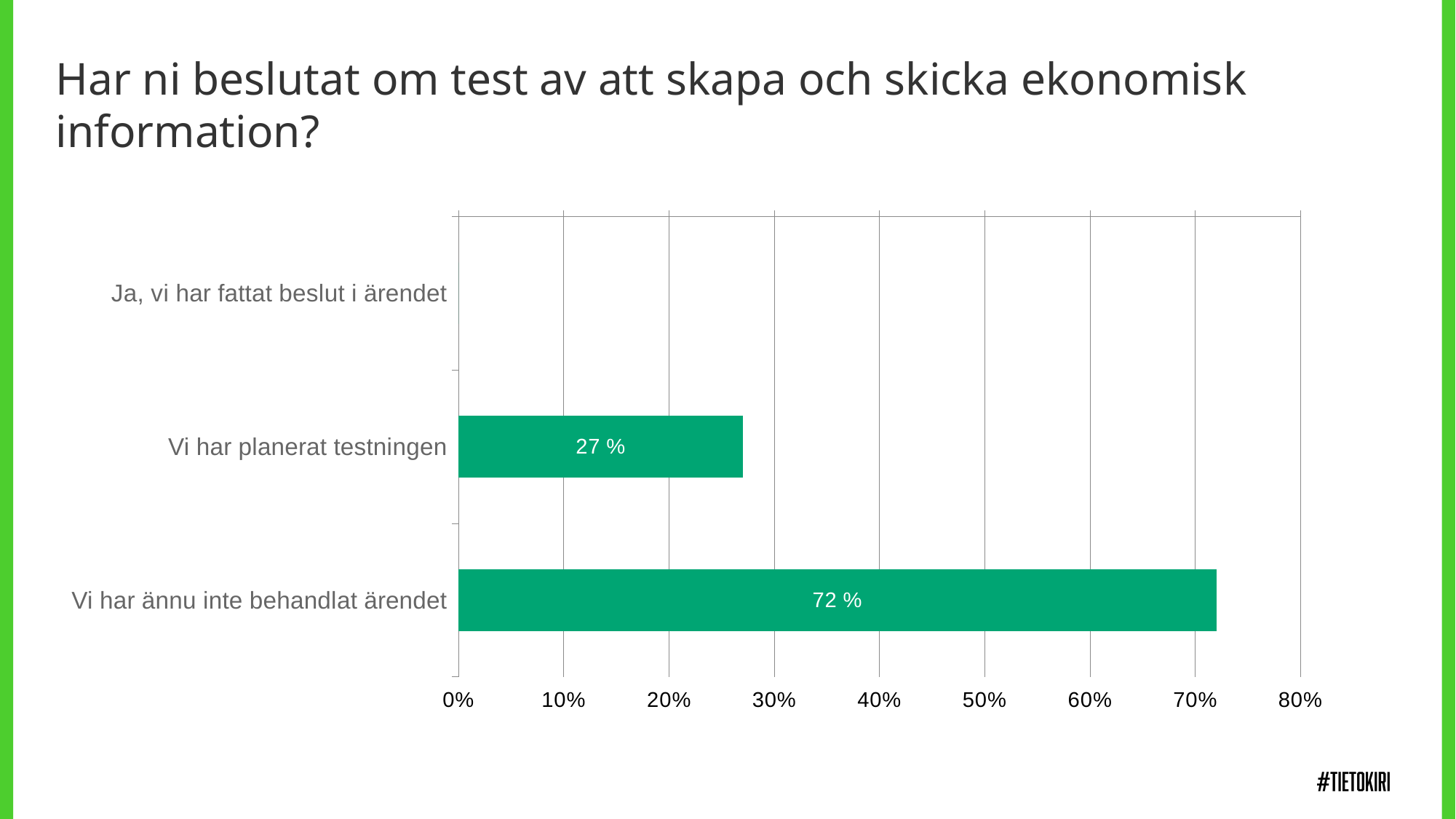
What is the value for "Vi har ännu inte behandlat ärendet"? 72 % Is the value for "Vi har planerat testningen" greater or less than 30%? less Which is larger, the value for "Vi har planerat testningen" or the value for "Vi har ännu inte behandlat ärendet"? Vi har ännu inte behandlat ärendet What is the value for "Vi har planerat testningen"? 27 % What is the difference between the values for "Vi har ännu inte behandlat ärendet" and "Vi har planerat testningen"? 45 % What kind of chart is shown on the slide? bar chart What is the title of the slide? Har ni beslutat om test av att skapa och skicka ekonomisk information? How many categories are shown on the chart? 3 Is the value for "Vi har ännu inte behandlat ärendet" greater or less than 50%? greater Which category has the highest value? Vi har ännu inte behandlat ärendet What colour are the bars in the chart? green Which category has the lowest value? Ja, vi har fattat beslut i ärendet